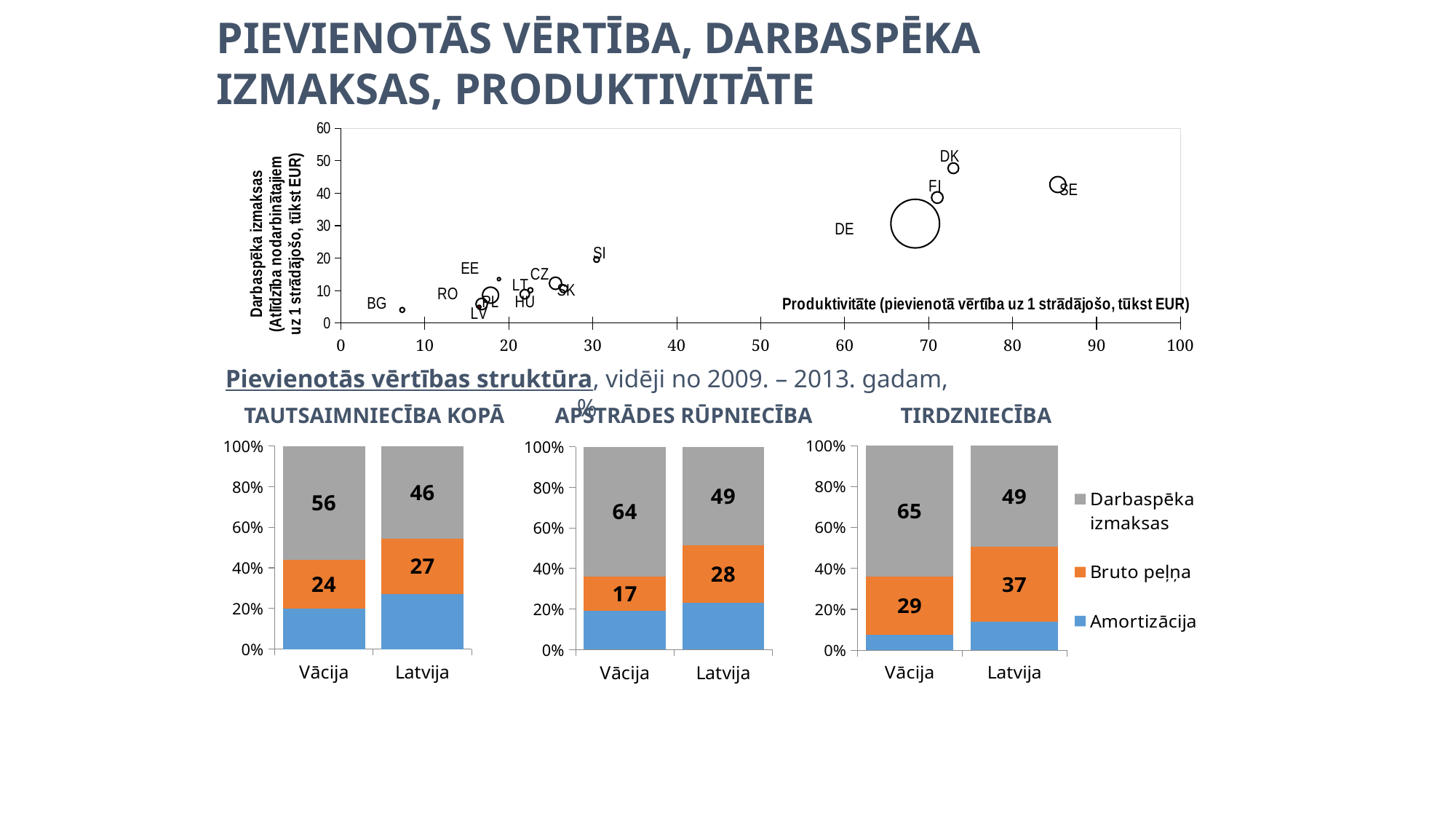
In the top bubble chart, is the Darbaspēka izmaksas value for DK greater or less than 40? greater How many series does the legend of the bottom stacked bar charts list? 3 How many countries are shown on the x axis of the 'Tautsaimniecība kopā' chart? 2 In the 'Tirdzniecība' chart, how much larger is Bruto peļņa for Latvija than for Vācija? 8 In the 'Tautsaimniecība kopā' chart, what is the value of Darbaspēka izmaksas for Vācija? 56 What kind of chart is the 'Tirdzniecība' chart? Stacked bar chart In the 'Apstrādes rūpniecība' chart, what is the value of Bruto peļņa for Latvija? 28 In the 'Tautsaimniecība kopā' chart, what is the difference between Darbaspēka izmaksas for Vācija and for Latvija? 10 In the 'Tirdzniecība' chart, what is the value of Darbaspēka izmaksas for Vācija? 65 What is the x-axis label of the top bubble chart? Produktivitāte (pievienotā vērtība uz 1 strādājošo, tūkst EUR) In the top bubble chart, is the Produktivitāte value for BG greater or less than 10? less In the 'Apstrādes rūpniecība' chart, which country has the larger Darbaspēka izmaksas share, Vācija or Latvija? Vācija